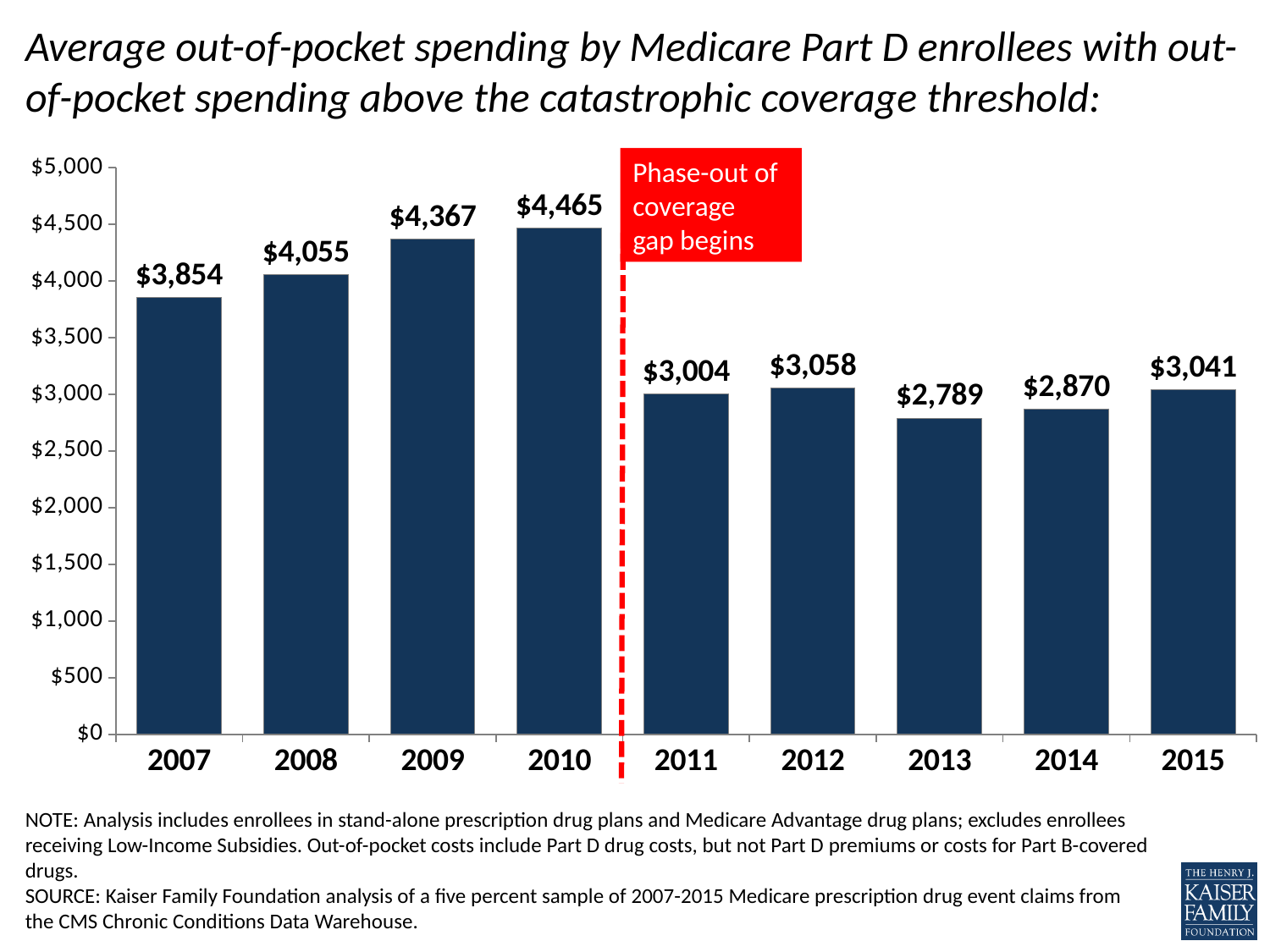
What is the difference in average out-of-pocket spending between 2010 and 2011? $1,461 What kind of chart is shown on the slide? Bar chart According to the red label on the chart, what begins in 2011? Phase-out of coverage gap What was the average out-of-pocket spending in 2013? $2,789 What was the average out-of-pocket spending in 2007? $3,854 Which year had higher average out-of-pocket spending, 2012 or 2015? 2012 How many years are shown on the chart? 9 Which year had the lowest average out-of-pocket spending? 2013 What was the average out-of-pocket spending in 2010? $4,465 What is the difference in average out-of-pocket spending between 2008 and 2007? $201 Is the value for 2014 greater or less than $3,000? less Which year had the highest average out-of-pocket spending? 2010